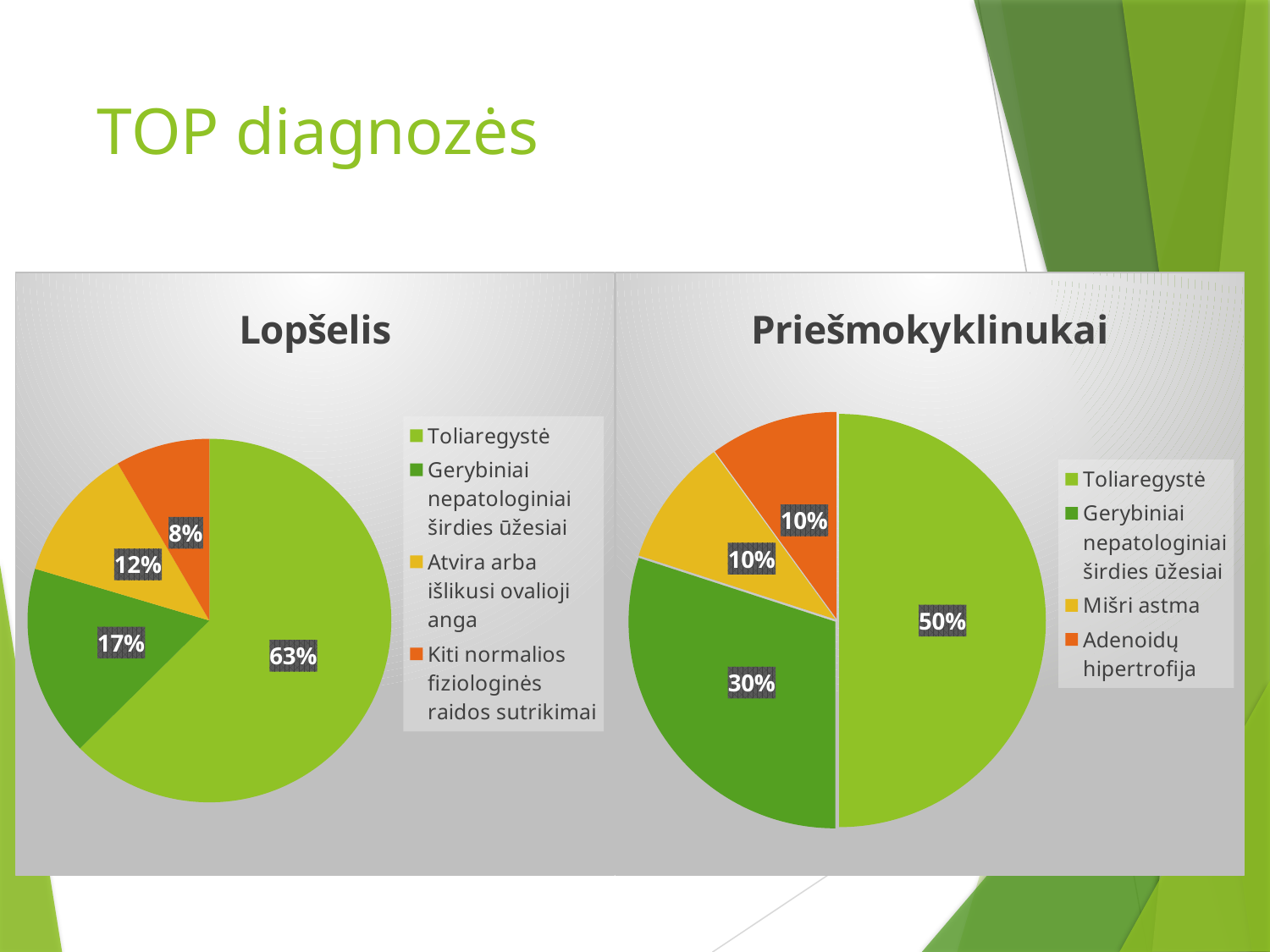
In the "Priešmokyklinukai" chart, what share does Gerybiniai nepatologiniai širdies ūžesiai have? 30% In the "Lopšelis" chart, what is the difference between the Toliaregystė share and the Gerybiniai nepatologiniai širdies ūžesiai share? 46% In the "Lopšelis" chart, what share does "Atvira arba išlikusi ovalioji anga" have? 12% In the "Lopšelis" chart, how many slices does the pie have? 4 In the "Lopšelis" chart, what share does Toliaregystė have? 63% What type of chart is the "Lopšelis" chart? Pie chart In the "Priešmokyklinukai" chart, what share does Toliaregystė have? 50% In the "Lopšelis" chart, which category has the smallest slice? Kiti normalios fiziologinės raidos sutrikimai In the "Priešmokyklinukai" chart, which category has the largest slice? Toliaregystė In the "Priešmokyklinukai" chart, how many entries does the legend list? 4 In the "Priešmokyklinukai" chart, which is larger: Mišri astma or Gerybiniai nepatologiniai širdies ūžesiai? Gerybiniai nepatologiniai širdies ūžesiai In the "Priešmokyklinukai" chart, what colour is the Adenoidų hipertrofija slice? Orange